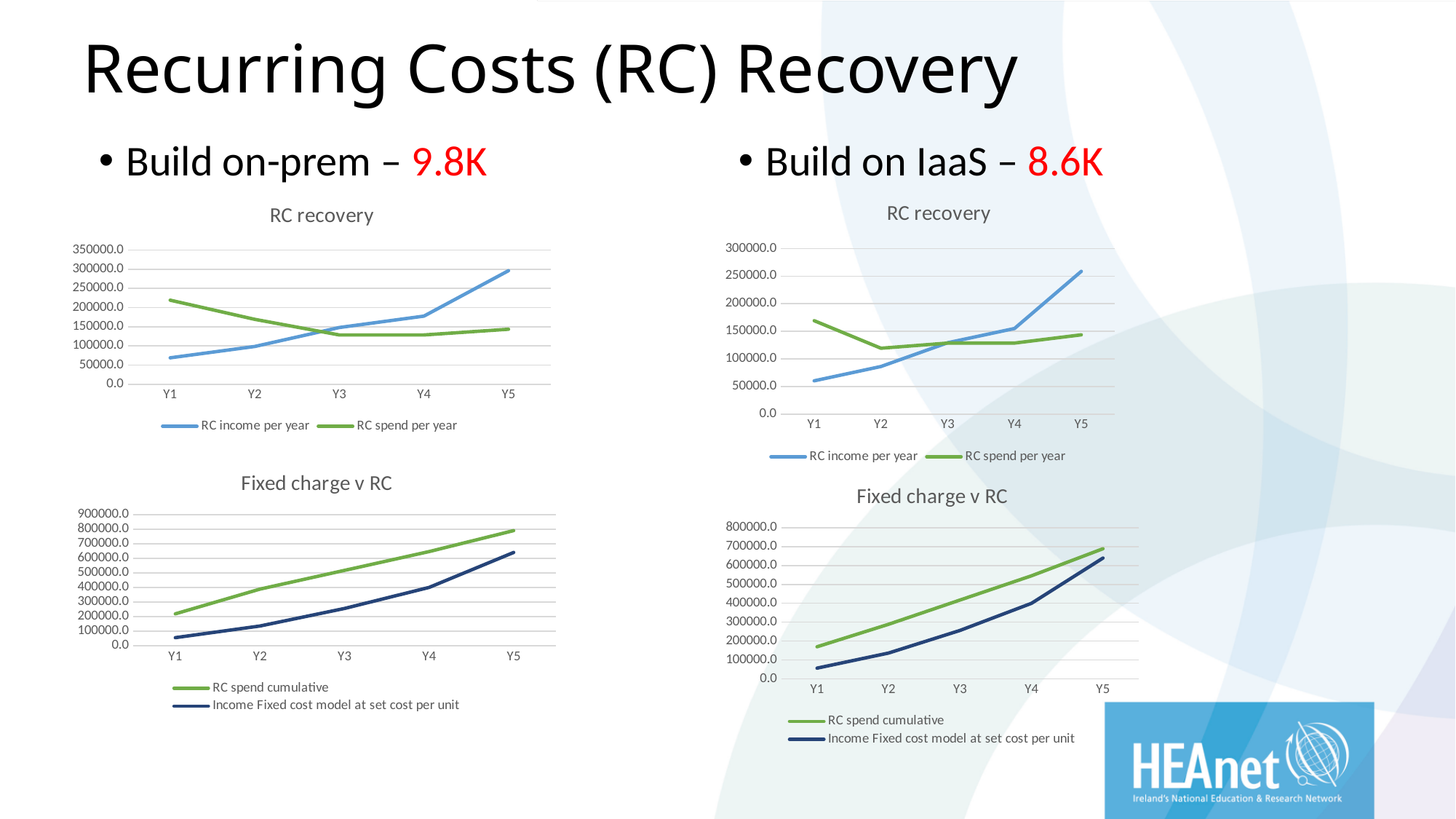
In the top-left 'RC recovery' chart (Build on-prem), how many series does the legend list? 2 In the bottom-left 'Fixed charge v RC' chart (Build on-prem), which series has the larger value at Y5, RC spend cumulative or Income Fixed cost model at set cost per unit? RC spend cumulative In the top-left 'RC recovery' chart (Build on-prem), which series has the larger value at Y1, RC income per year or RC spend per year? RC spend per year In the bottom-right 'Fixed charge v RC' chart (Build on IaaS), is the value of RC spend cumulative at Y5 greater or less than 600000.0? greater In the top-left 'RC recovery' chart (Build on-prem), is the value of RC income per year at Y5 greater or less than 250000.0? greater In the top-left 'RC recovery' chart (Build on-prem), is the value of RC spend per year at Y1 greater or less than 200000.0? greater In the top-left 'RC recovery' chart (Build on-prem), in which year is RC income per year lowest? Y1 In the top-right 'RC recovery' chart (Build on IaaS), in which year is RC income per year highest? Y5 In the top-left 'RC recovery' chart (Build on-prem), how many years are shown on the x axis? 5 In the top-left 'RC recovery' chart (Build on-prem), does RC income per year rise or fall from Y1 to Y5? Rise What kind of chart is the top-left 'RC recovery' chart under 'Build on-prem'? Line chart